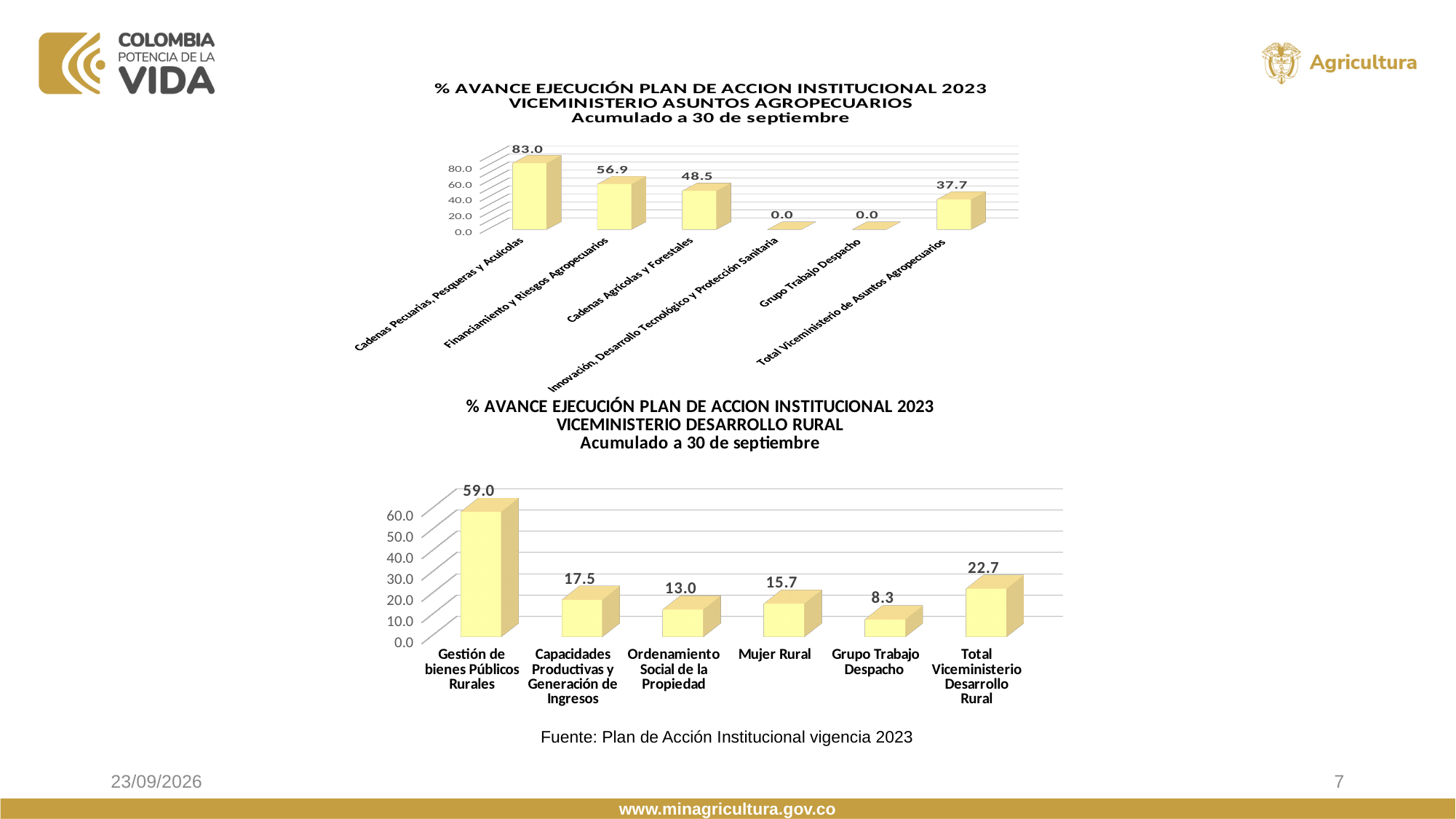
In the top chart (Viceministerio Asuntos Agropecuarios), which category has the highest value? Cadenas Pecuarias, Pesqueras y Acuícolas In the bottom chart (Viceministerio Desarrollo Rural), what is the value for Total Viceministerio Desarrollo Rural? 22.7 In the bottom chart (Viceministerio Desarrollo Rural), which is larger: Capacidades Productivas y Generación de Ingresos or Ordenamiento Social de la Propiedad? Capacidades Productivas y Generación de Ingresos In the top chart (Viceministerio Asuntos Agropecuarios), what is the value for Financiamiento y Riesgos Agropecuarios? 56.9 What kind of chart is the bottom chart (Viceministerio Desarrollo Rural)? Bar chart In the top chart (Viceministerio Asuntos Agropecuarios), what is the value for Total Viceministerio de Asuntos Agropecuarios? 37.7 In the bottom chart (Viceministerio Desarrollo Rural), which category has the lowest value? Grupo Trabajo Despacho In the top chart (Viceministerio Asuntos Agropecuarios), what is the value for Cadenas Pecuarias, Pesqueras y Acuícolas? 83.0 In the bottom chart (Viceministerio Desarrollo Rural), what is the difference between Gestión de bienes Públicos Rurales and Grupo Trabajo Despacho? 50.7 In the bottom chart (Viceministerio Desarrollo Rural), what is the value for Mujer Rural? 15.7 In the top chart (Viceministerio Asuntos Agropecuarios), what is the difference between Cadenas Pecuarias, Pesqueras y Acuícolas and Cadenas Agrícolas y Forestales? 34.5 In the top chart (Viceministerio Asuntos Agropecuarios), how many categories are shown? 6